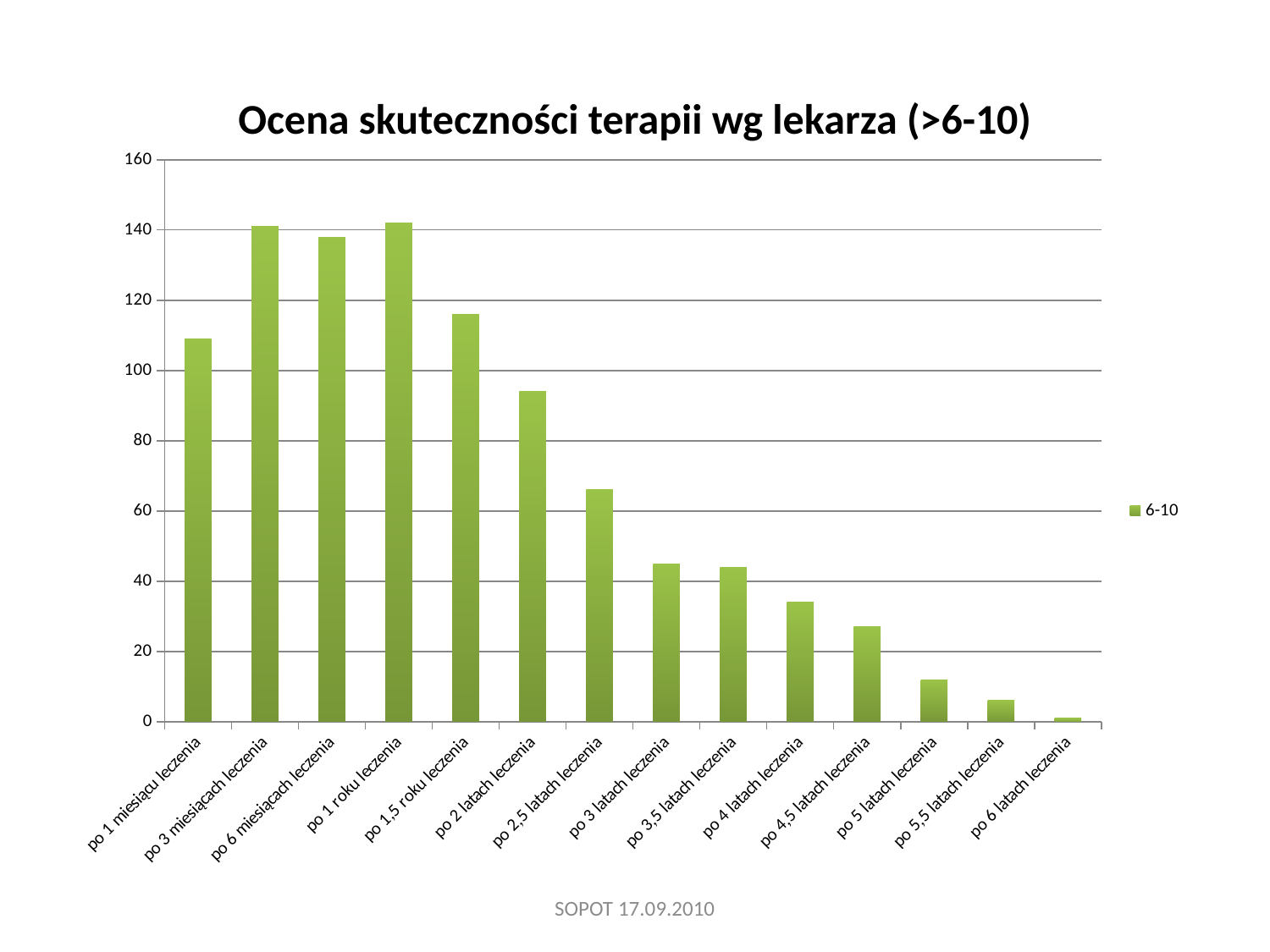
What is the legend entry for the series? 6-10 Is the value for 'po 2 latach leczenia' greater or less than 100? less How many series does the legend list? 1 Is the value for 'po 1 miesiącu leczenia' greater or less than 100? greater How many categories are plotted along the x axis? 14 Which category has the lowest value? po 6 latach leczenia What is the title of the chart? Ocena skuteczności terapii wg lekarza (>6-10) From 'po 1 roku leczenia' onward, do the values rise or fall along the x axis? fall What kind of chart is shown on the slide? bar chart Is the value for 'po 4 latach leczenia' greater or less than 40? less Which is larger, the value for 'po 2,5 latach leczenia' or 'po 3 latach leczenia'? po 2,5 latach leczenia